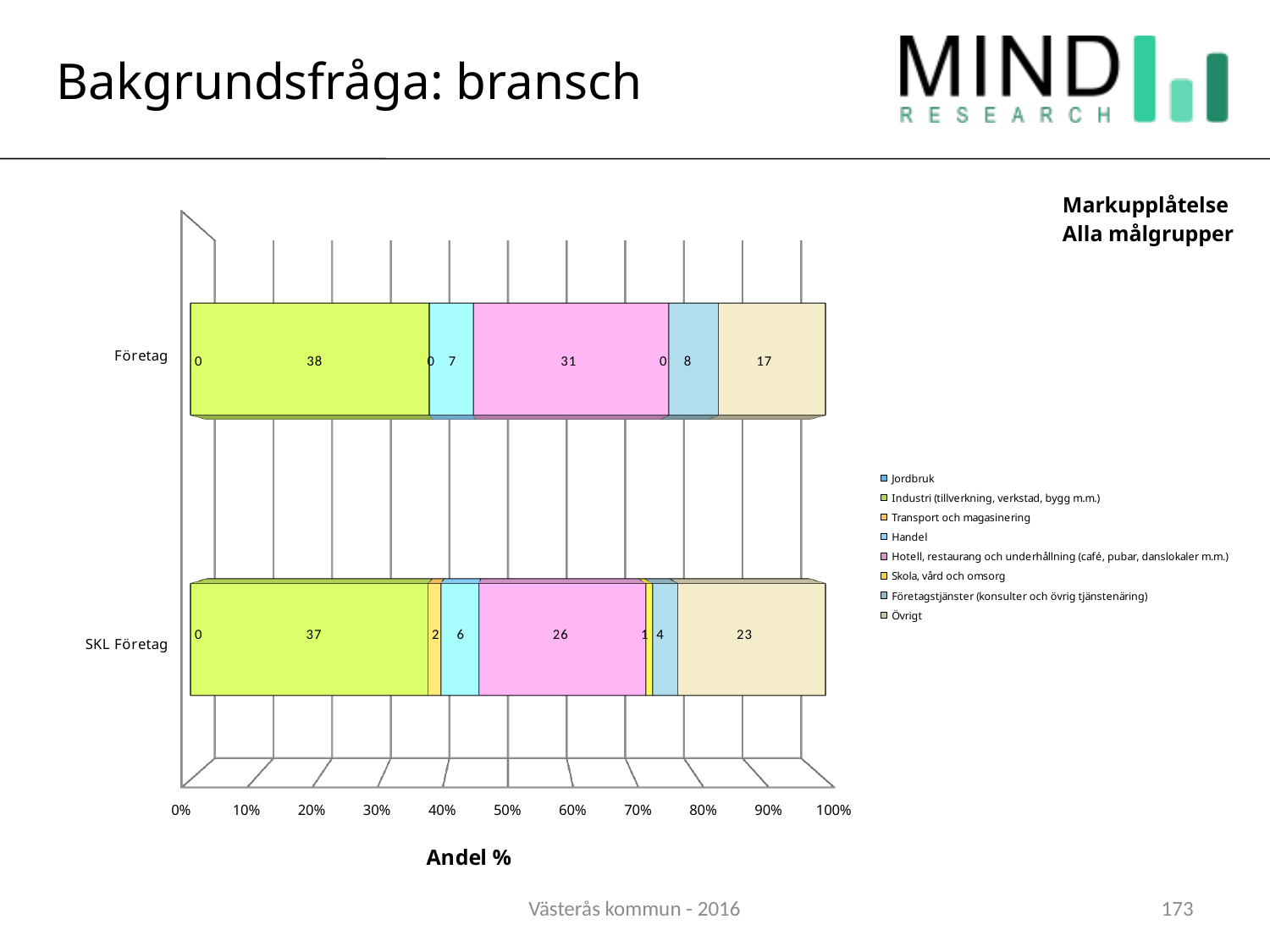
What kind of chart is shown on the slide? Stacked bar chart Which series has the largest segment in the SKL Företag bar? Industri (tillverkning, verkstad, bygg m.m.) What is the value for Övrigt in the SKL Företag bar? 23 Which category has the larger value for Företagstjänster, Företag or SKL Företag? Företag What is the difference between the Industri values for Företag and SKL Företag? 1 What is the value for Hotell, restaurang och underhållning in the SKL Företag bar? 26 How many series does the legend list? 8 What is the value for Handel in the Företag bar? 7 How many categories (bars) are shown in the chart? 2 What is the difference between the Övrigt values for SKL Företag and Företag? 6 Which category has the larger value for Hotell, restaurang och underhållning, Företag or SKL Företag? Företag What is the value for Industri (tillverkning, verkstad, bygg m.m.) in the Företag bar? 38